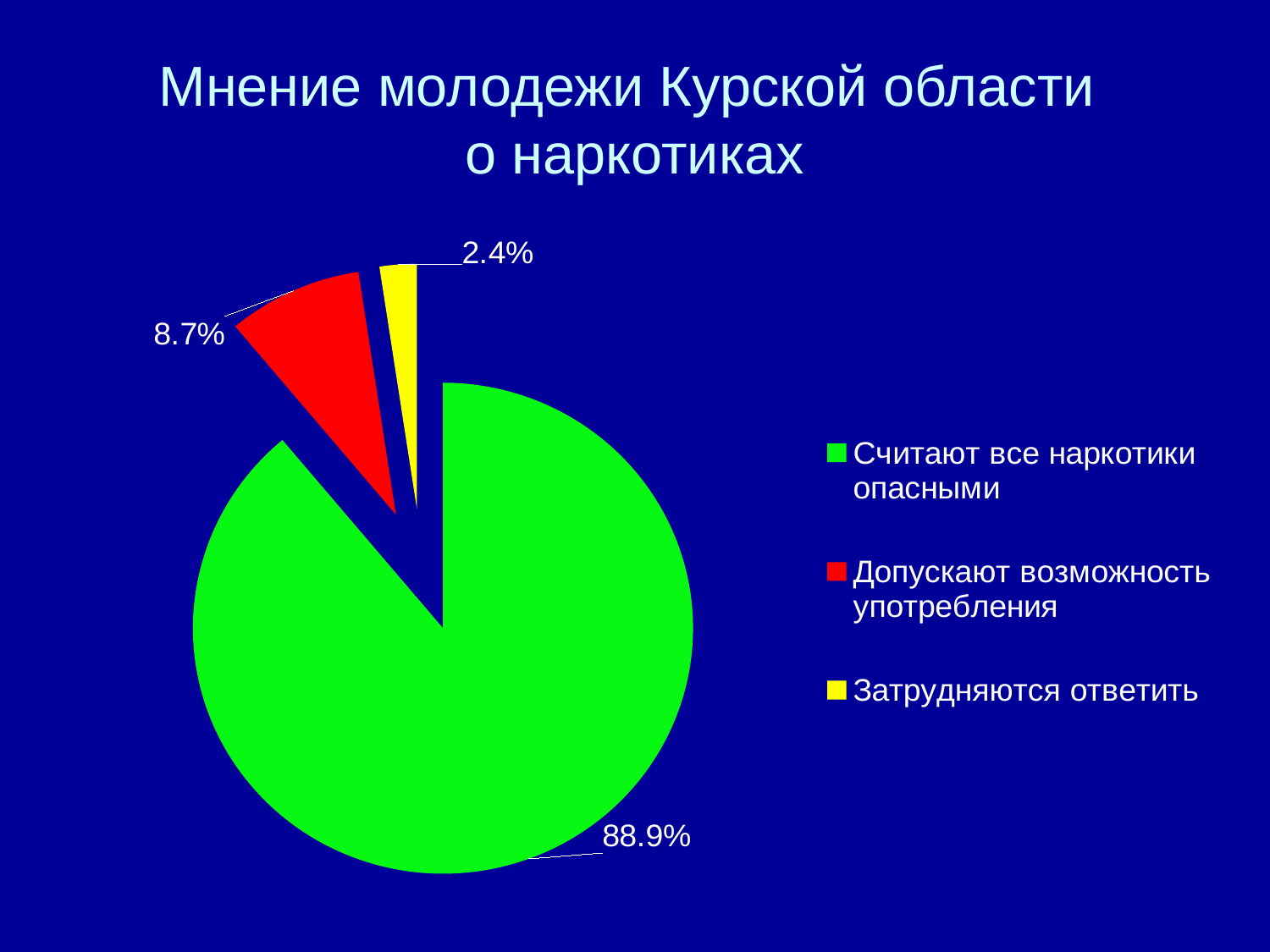
What share of the pie is labelled "Считают все наркотики опасными"? 88.9% How many entries does the legend list? 3 What is the difference in percentage points between "Допускают возможность употребления" and "Затрудняются ответить"? 6.3 What share of the pie is labelled "Допускают возможность употребления"? 8.7% What is the title of the slide? Мнение молодежи Курской области о наркотиках Which category has the smallest slice of the pie? Затрудняются ответить What kind of chart is shown on the slide? pie chart What share of the pie is labelled "Затрудняются ответить"? 2.4% What colour is the slice for "Затрудняются ответить"? yellow How many slices does the pie chart have? 3 Which is larger: the slice for "Допускают возможность употребления" or the slice for "Затрудняются ответить"? Допускают возможность употребления Which category has the largest slice of the pie? Считают все наркотики опасными